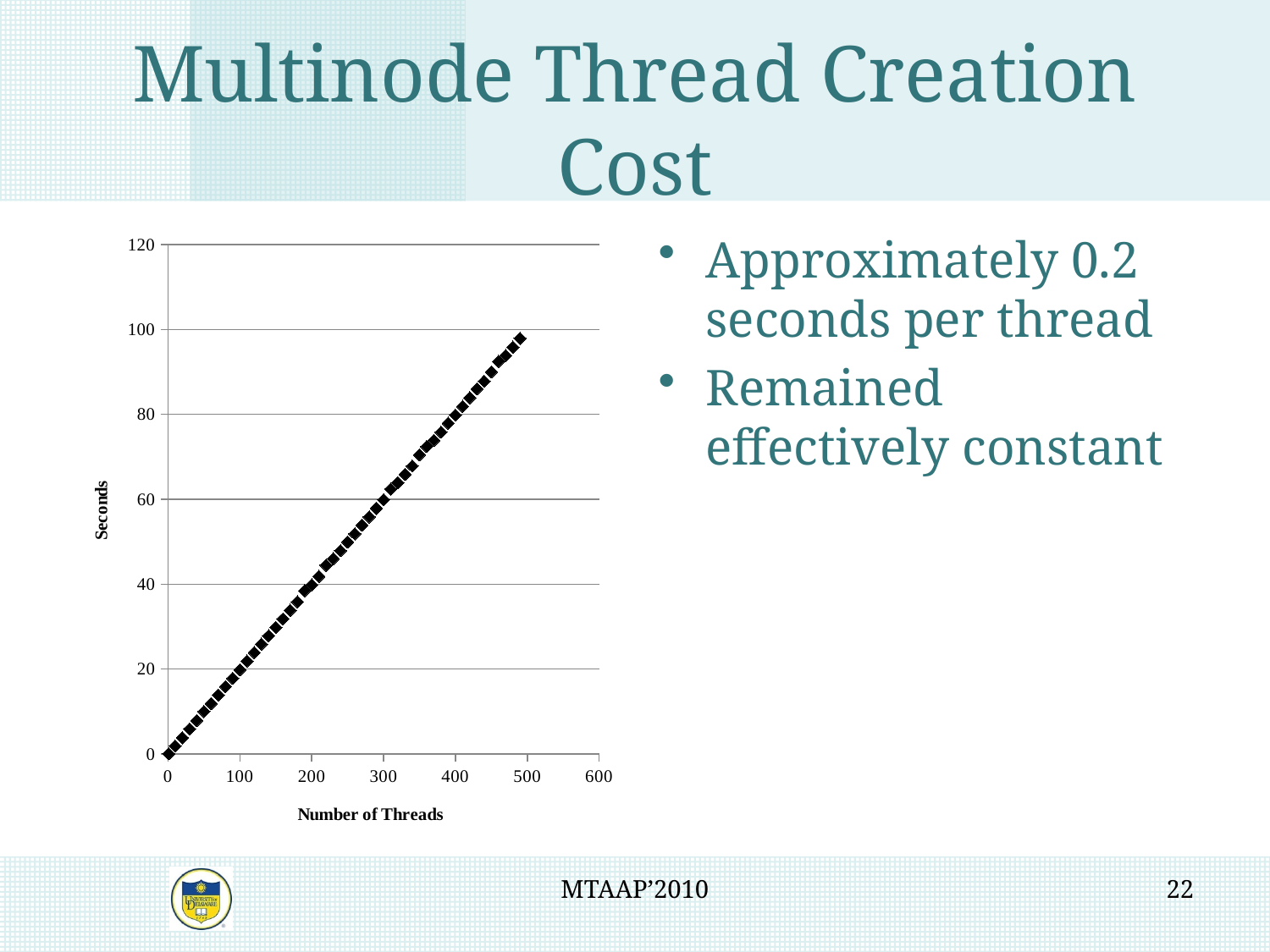
Is the highest plotted value in seconds greater or less than 100? less What kind of chart is shown on the slide? scatter chart Is the value in seconds at 250 threads greater or less than 40? greater What is the label of the x axis? Number of Threads Is the value in seconds at 150 threads greater or less than 40? less Do the values in seconds rise or fall as the number of threads increases? rise What is the label of the y axis? Seconds Which has the larger value in seconds: 100 threads or 400 threads? 400 threads